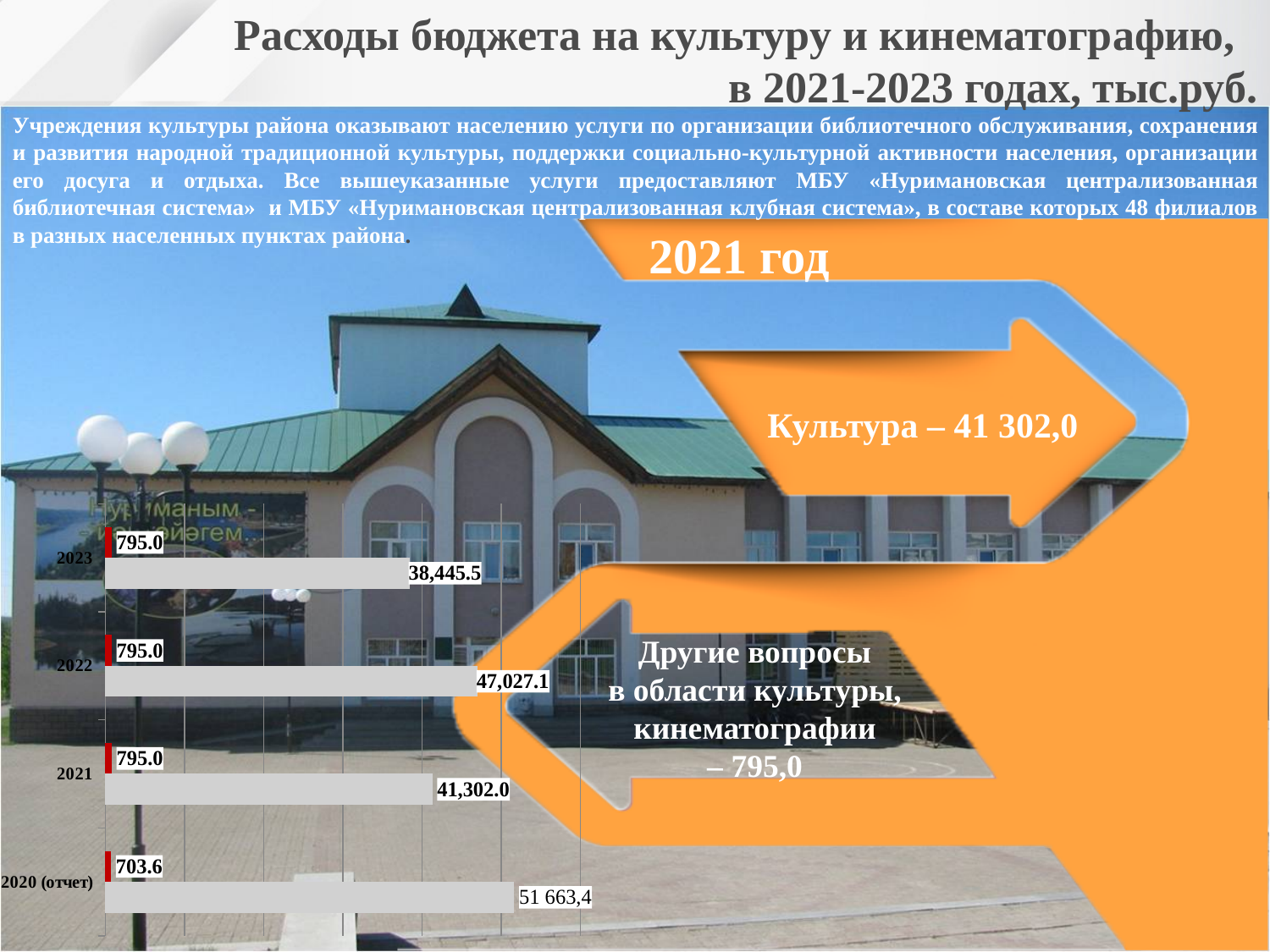
What is the value of the red bar for 2021? 795.0 What is the value of the grey bar for 2020 (отчет)? 51 663,4 What is the value of the grey bar for 2023? 38,445.5 What is the value of the red bar for 2020 (отчет)? 703.6 How many year categories does the bar chart show? 4 What is the difference between the grey bar values for 2022 and 2023? 8,581.6 What type of chart is shown on the slide? bar chart What is the value of the grey bar for 2021? 41,302.0 What is the value of the grey bar for 2022? 47,027.1 Which year has the lowest grey bar value? 2023 Which is larger, the grey bar value for 2022 or for 2021? 2022 Which year has the highest grey bar value? 2020 (отчет)